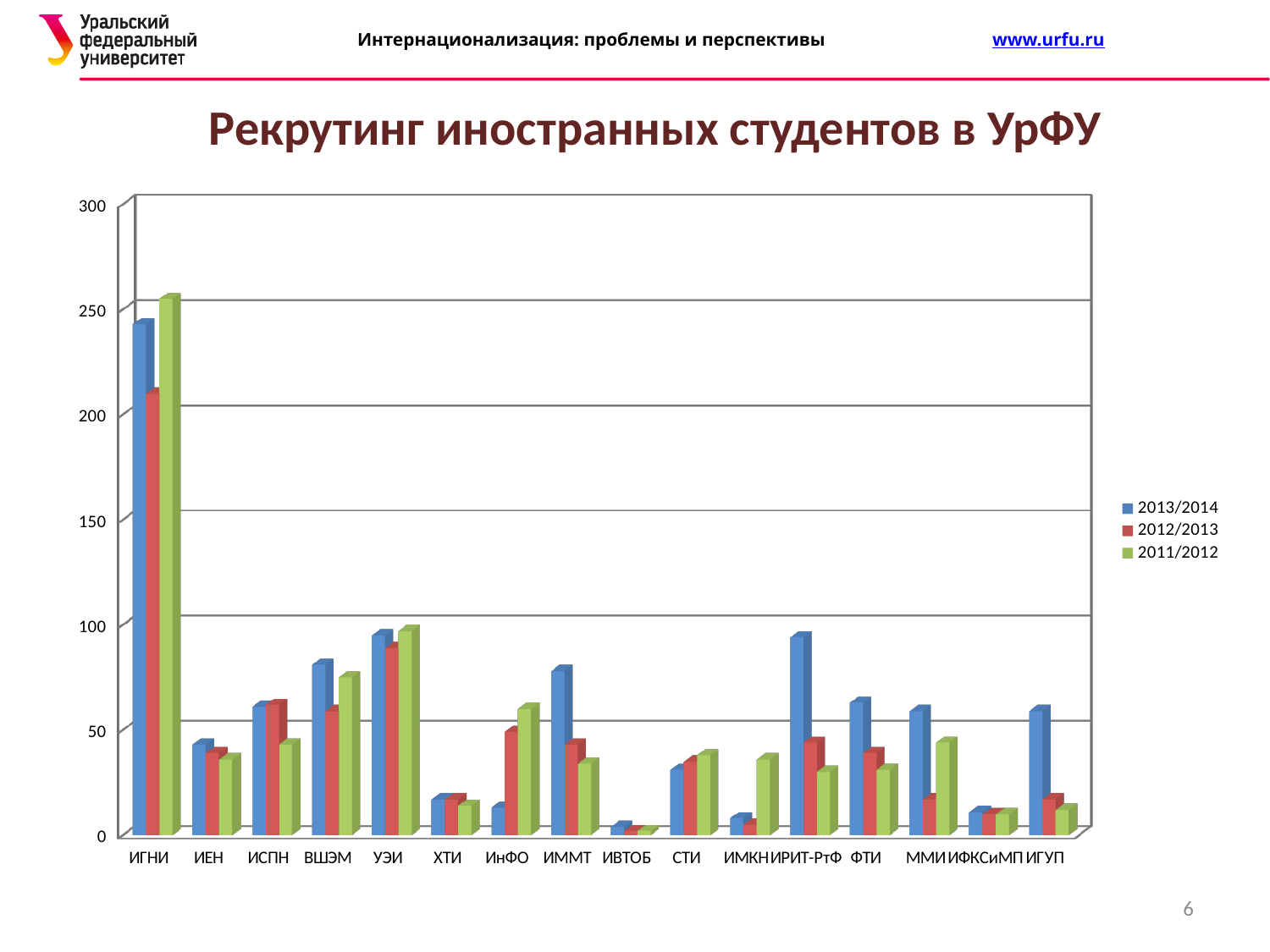
Is the value for ИРИТ-РтФ in 2013/2014 greater or less than 100? less What kind of chart is shown on the slide? bar chart Is the value for ВШЭМ in 2013/2014 greater or less than 50? greater Which category has the lowest value for the 2011/2012 series? ИВТОБ Which category has the highest value for the 2013/2014 series? ИГНИ Is the value for ИГНИ in 2013/2014 greater or less than 200? greater How many series does the legend list? 3 Which has the larger 2013/2014 value: ИГНИ or ИЕН? ИГНИ For ИнФО, which series has the larger value: 2013/2014 or 2011/2012? 2011/2012 What is the title of the chart? Рекрутинг иностранных студентов в УрФУ How many categories (institutes) are shown on the x axis? 16